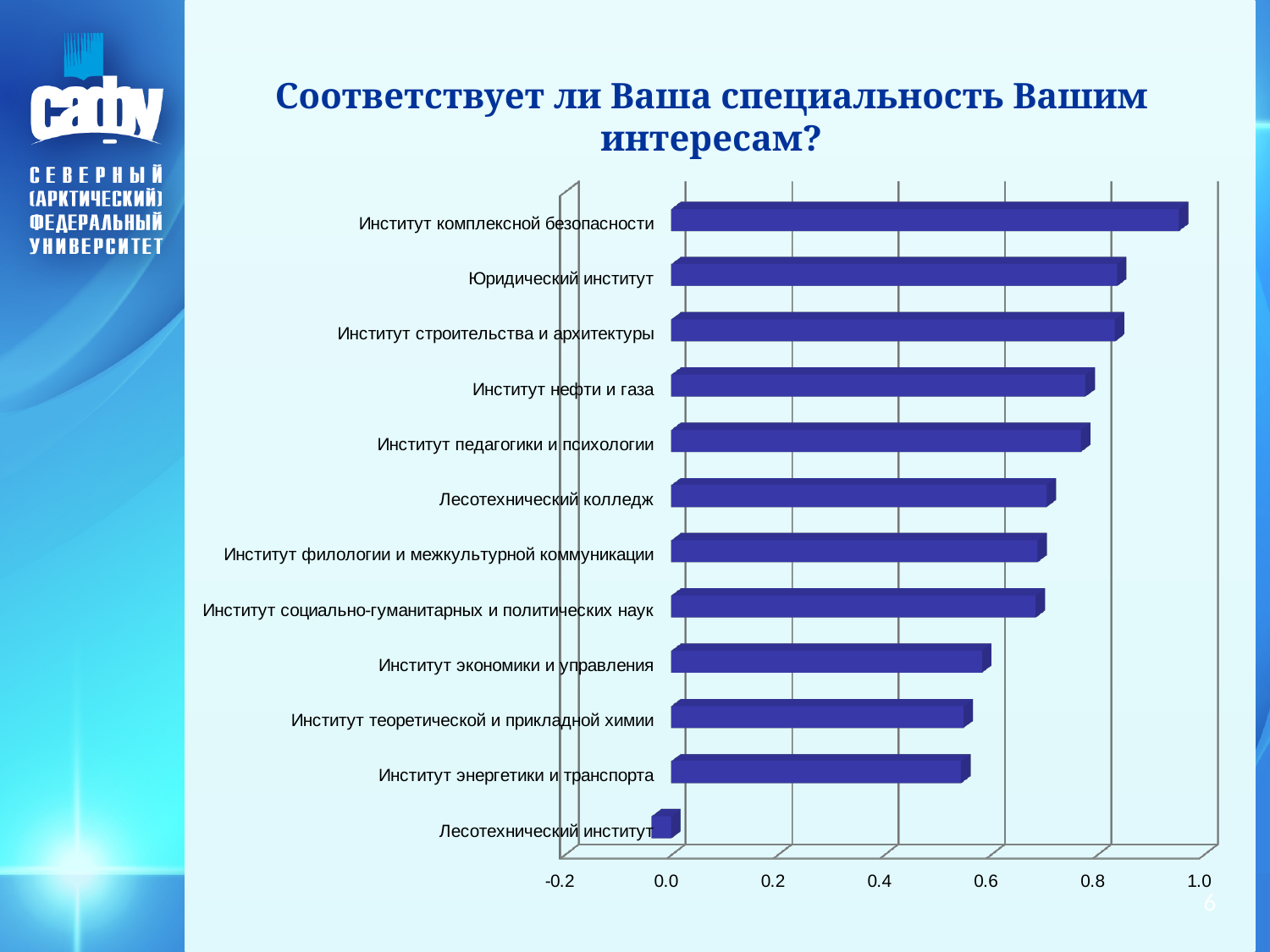
Do the bar values increase or decrease going from the top category to the bottom category? decrease Which institute has the lowest value in the chart? Лесотехнический институт Which institute has the highest value in the chart? Институт комплексной безопасности What kind of chart is shown on the slide? Bar chart What is the title of the chart on the slide? Соответствует ли Ваша специальность Вашим интересам? Is the value for Институт теоретической и прикладной химии greater or less than 0.6? less Is the value for Лесотехнический колледж greater or less than 0.6? greater Is the value for Институт энергетики и транспорта greater or less than 0.6? less Which has the larger value: Юридический институт or Институт нефти и газа? Юридический институт Which has the larger value: Институт экономики и управления or Лесотехнический колледж? Лесотехнический колледж How many institutes (categories) are plotted in the chart? 12